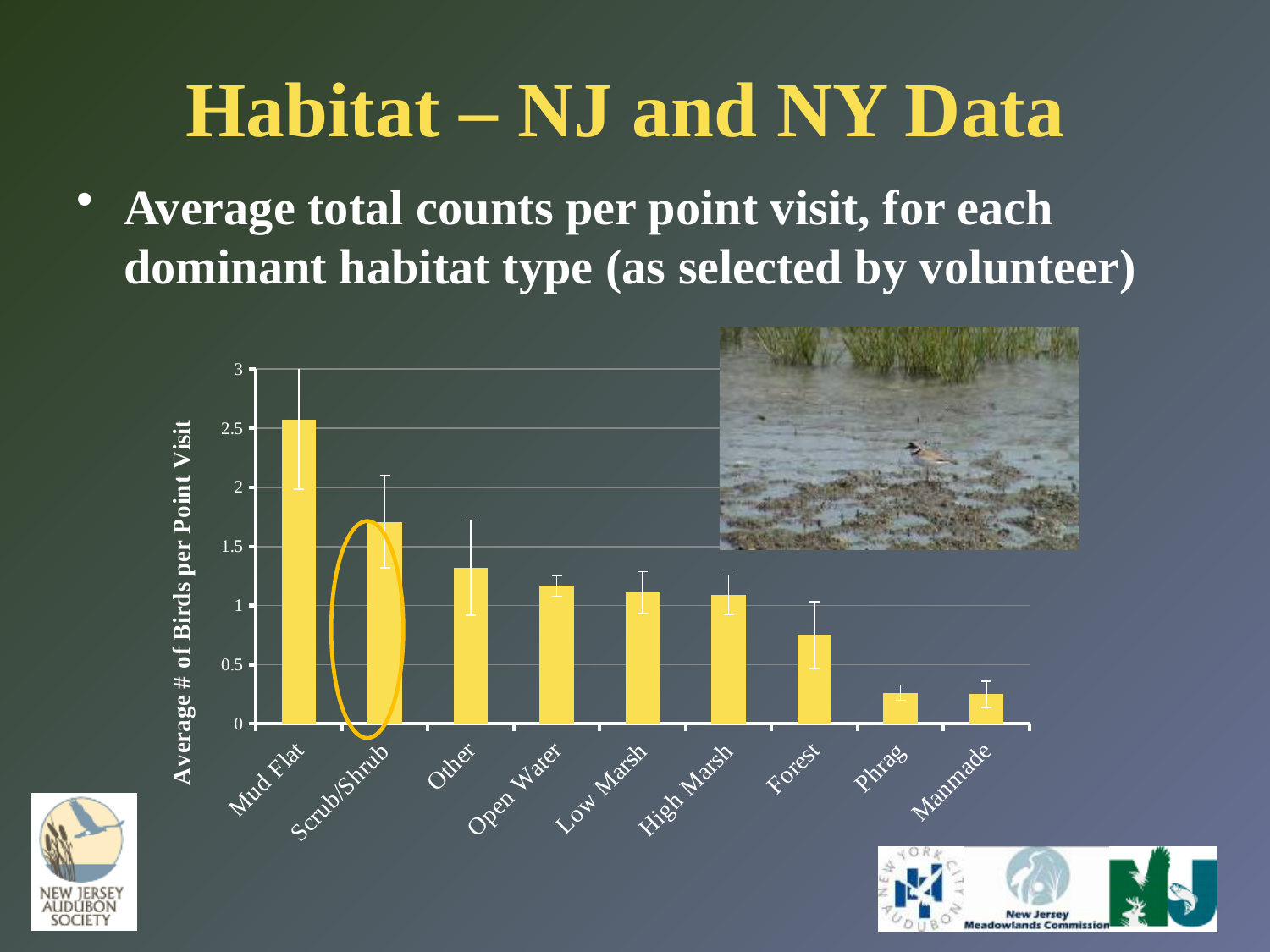
Is the value for Scrub/Shrub greater or less than 1.5? greater Is the value for Forest greater or less than 1? less Which habitat type has the highest average number of birds per point visit? Mud Flat Which has a higher average number of birds per point visit, Mud Flat or Scrub/Shrub? Mud Flat What kind of chart is shown on the slide? bar chart What is the label on the vertical axis of the chart? Average # of Birds per Point Visit Is the value for Other greater or less than 1? greater Do the bar values rise or fall moving from left to right along the x axis? fall Which has a higher average number of birds per point visit, Other or Forest? Other How many habitat categories are plotted on the x axis? 9